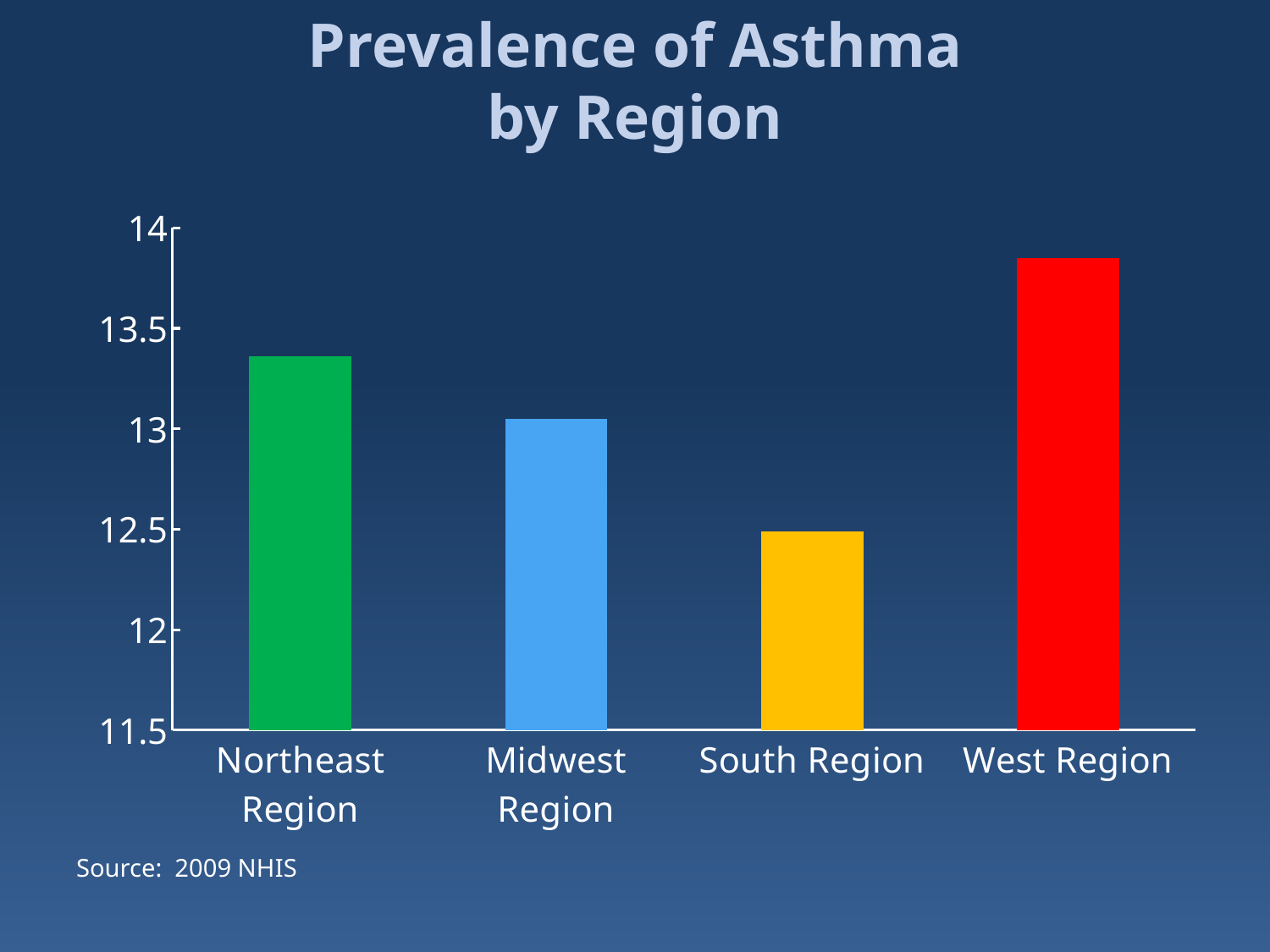
What colour is the bar for the West Region? red Is the value for the Northeast Region greater or less than 13.5? less What kind of chart is shown on the slide? bar chart Is the value for the West Region greater or less than 13.5? greater Which region has the lowest asthma prevalence? South Region Is the value for the Northeast Region greater or less than 13? greater Which region has the highest asthma prevalence? West Region Which has a higher asthma prevalence, the Northeast Region or the Midwest Region? Northeast Region What is the title of the chart? Prevalence of Asthma by Region Which has a higher asthma prevalence, the South Region or the West Region? West Region How many regions are shown on the chart? 4